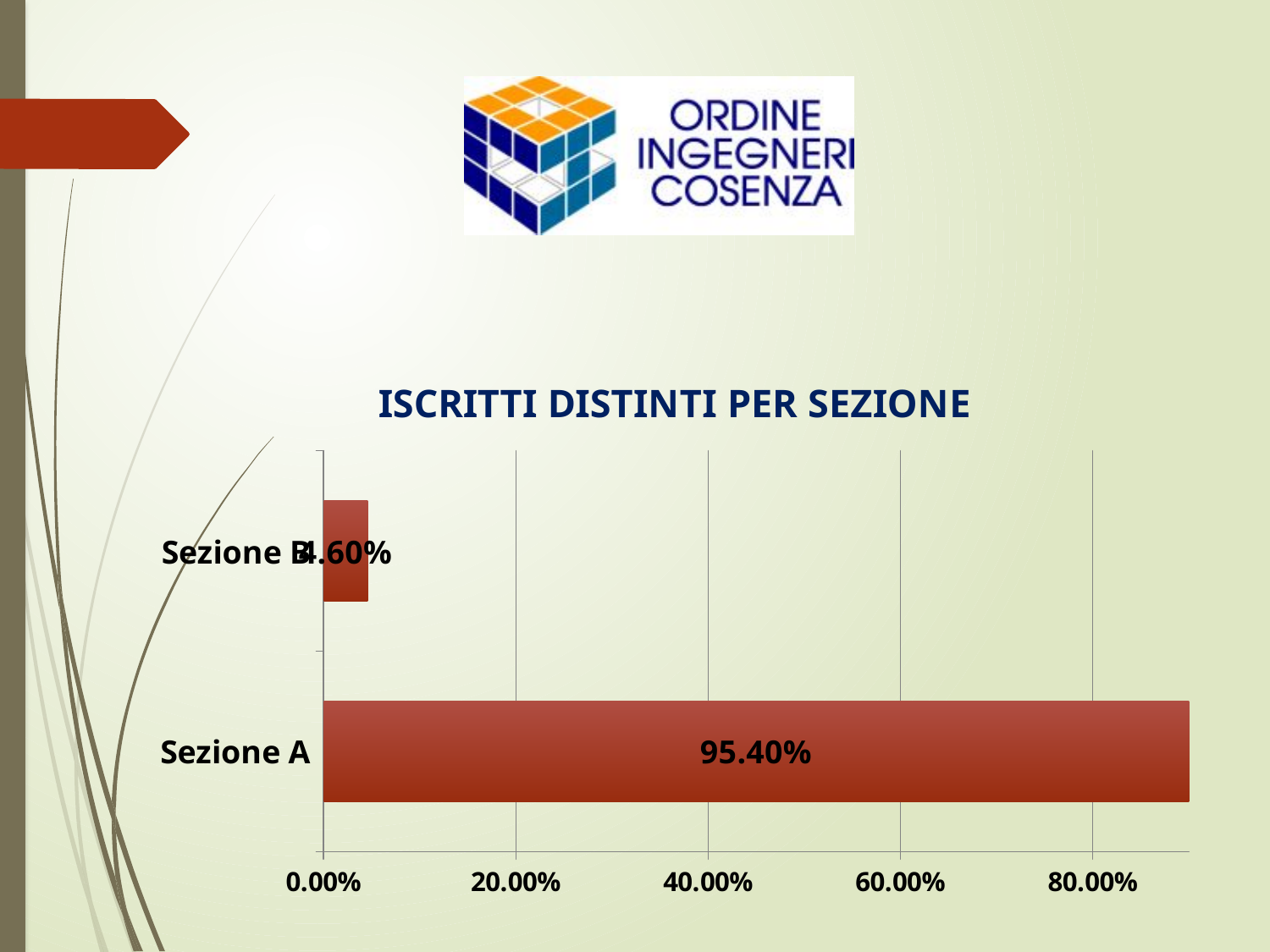
Which section has the highest value? Sezione A What is the title of the chart? ISCRITTI DISTINTI PER SEZIONE Is the value for Sezione B greater or less than 20.00%? less How many categories are shown in the chart? 2 Which section has the lowest value? Sezione B Is the value for Sezione A greater or less than 60.00%? greater Which is larger, the value for Sezione A or the value for Sezione B? Sezione A What is the value for Sezione A? 95.40% What colour are the bars in the chart? red What kind of chart is shown on the slide? bar chart Is the value for Sezione A greater or less than 80.00%? greater